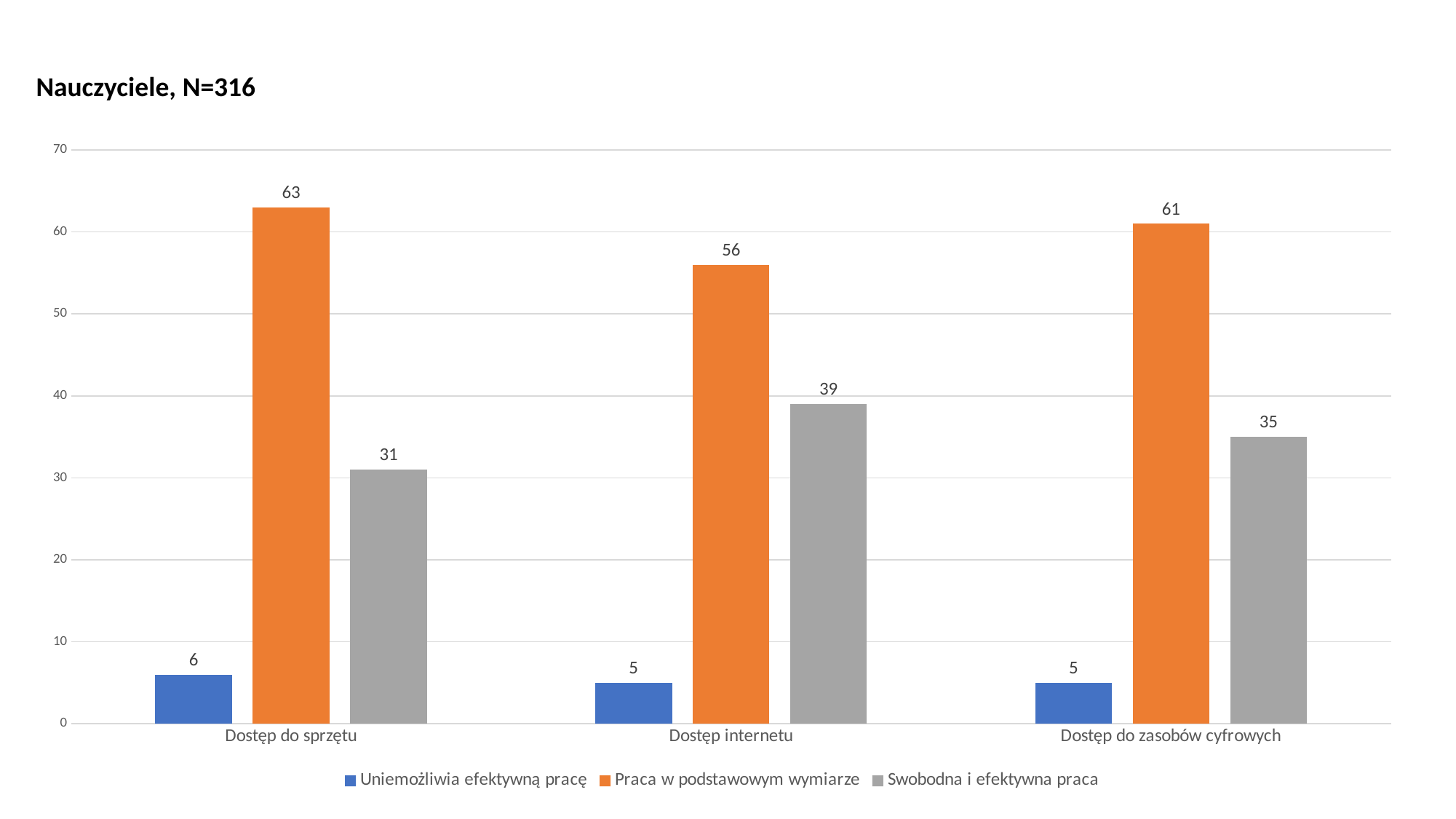
How many series does the legend list? 3 Which category has the lowest value for 'Swobodna i efektywna praca'? Dostęp do sprzętu Which category has the highest value for 'Praca w podstawowym wymiarze'? Dostęp do sprzętu How many categories are shown on the x axis? 3 Which is larger: 'Swobodna i efektywna praca' for 'Dostęp internetu' or for 'Dostęp do zasobów cyfrowych'? Dostęp internetu What is the value for 'Praca w podstawowym wymiarze' in the 'Dostęp do sprzętu' category? 63 Is the value for 'Praca w podstawowym wymiarze' in 'Dostęp internetu' greater or less than 50? greater What is the value for 'Swobodna i efektywna praca' in the 'Dostęp internetu' category? 39 What is the difference between the 'Praca w podstawowym wymiarze' and 'Swobodna i efektywna praca' values in the 'Dostęp do zasobów cyfrowych' category? 26 What kind of chart is shown on the slide? bar chart What is the title of the chart? Nauczyciele, N=316 What is the value for 'Uniemożliwia efektywną pracę' in the 'Dostęp do zasobów cyfrowych' category? 5